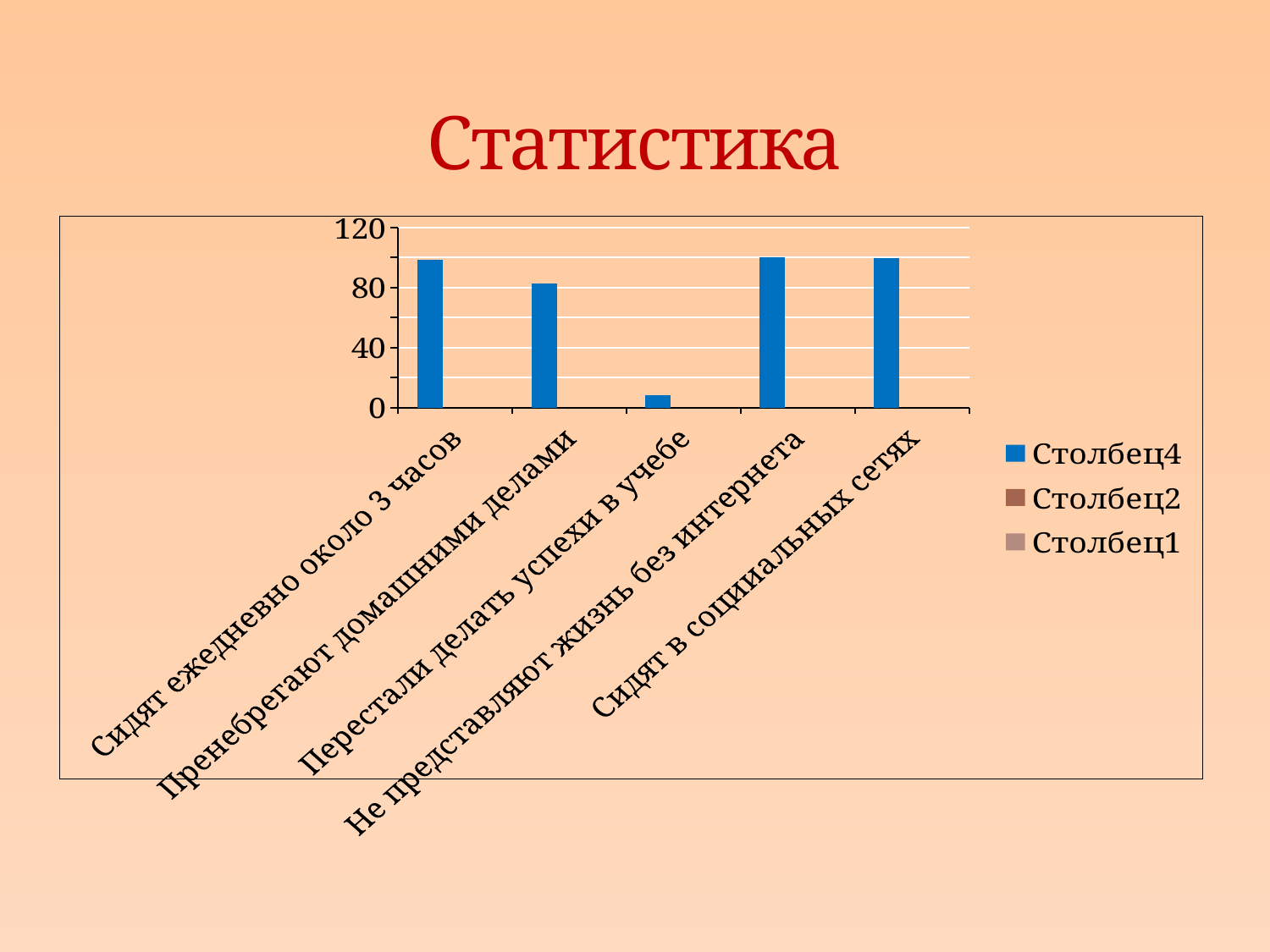
How many series does the chart's legend list? 3 Is the value for "Сидят в социиальных сетях" greater or less than 80? greater What colour are the bars for the series "Столбец4"? blue Which is larger: the value for "Не представляют жизнь без интернета" or for "Перестали делать успехи в учебе"? Не представляют жизнь без интернета Is the value for "Сидят ежедневно около 3 часов" greater or less than 80? greater How many categories are shown on the x axis of the chart? 5 What kind of chart is shown on the slide? bar chart Which category has the lowest value in the chart? Перестали делать успехи в учебе Is the value for "Пренебрегают домашними делами" greater or less than 40? greater What is the title of the slide with the chart? Статистика Which is larger: the value for "Сидят ежедневно около 3 часов" or for "Пренебрегают домашними делами"? Сидят ежедневно около 3 часов